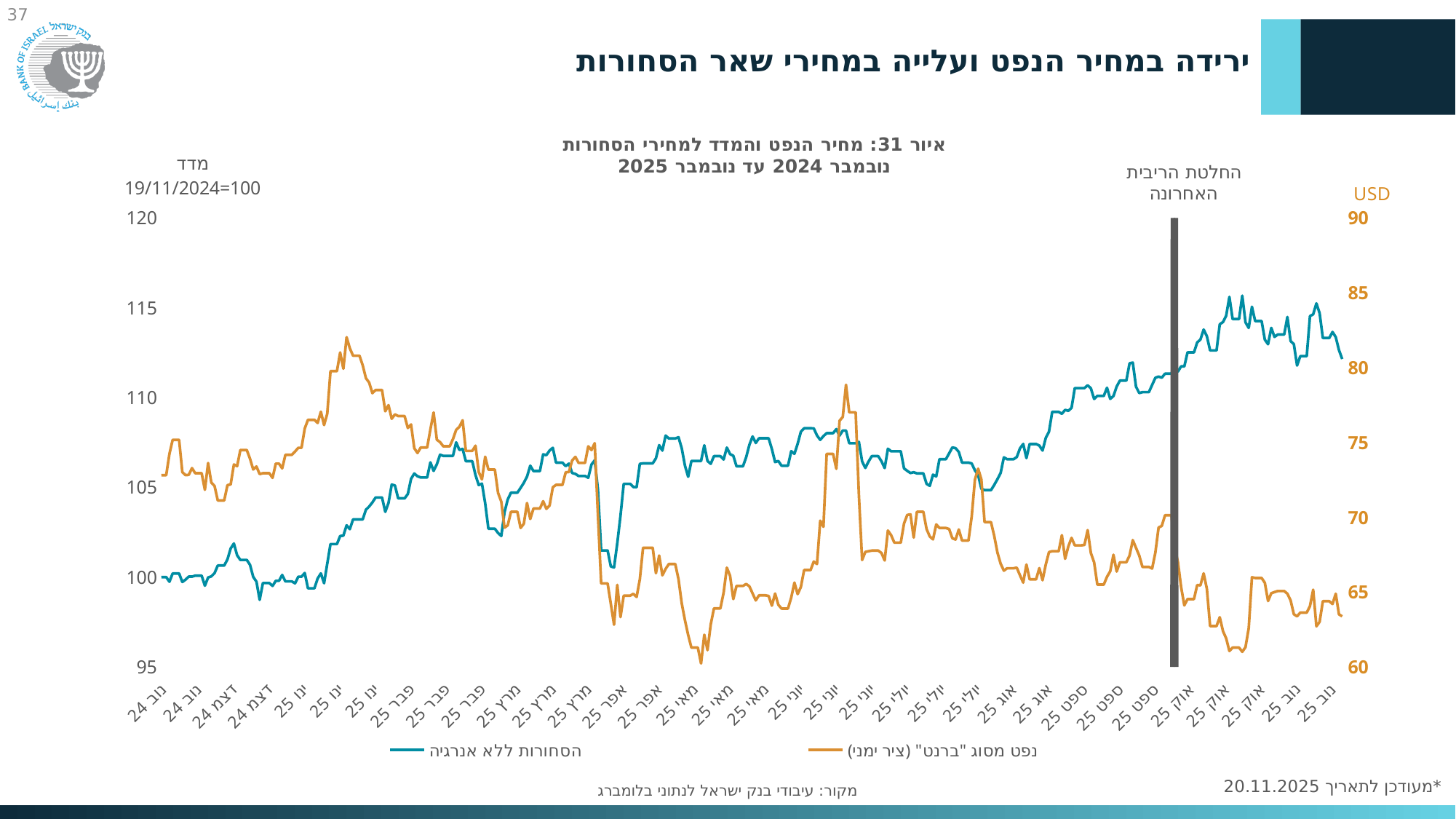
How many series does the legend list? 2 Is the peak of the Brent oil price in January 2025 greater or less than 80 USD? greater Which series is plotted on the right-hand USD axis? נפט מסוג "ברנט" Is the lowest Brent oil price in May 2025 greater or less than 65 USD? less Does the non-energy commodities index rise or fall overall from November 2024 to November 2025? rise In which month does the Brent oil price reach its highest level on the chart? January 2025 What is the value of the non-energy commodities index (הסחורות ללא אנרגיה) at the start of the series in November 2024? 100 What does the vertical dark line on the chart mark? החלטת הריבית האחרונה Is the non-energy commodities index at the end of the series (November 2025) greater or less than 110? greater Does the Brent oil price rise or fall overall from its January 2025 peak to November 2025? fall What kind of chart is shown on the slide? line chart